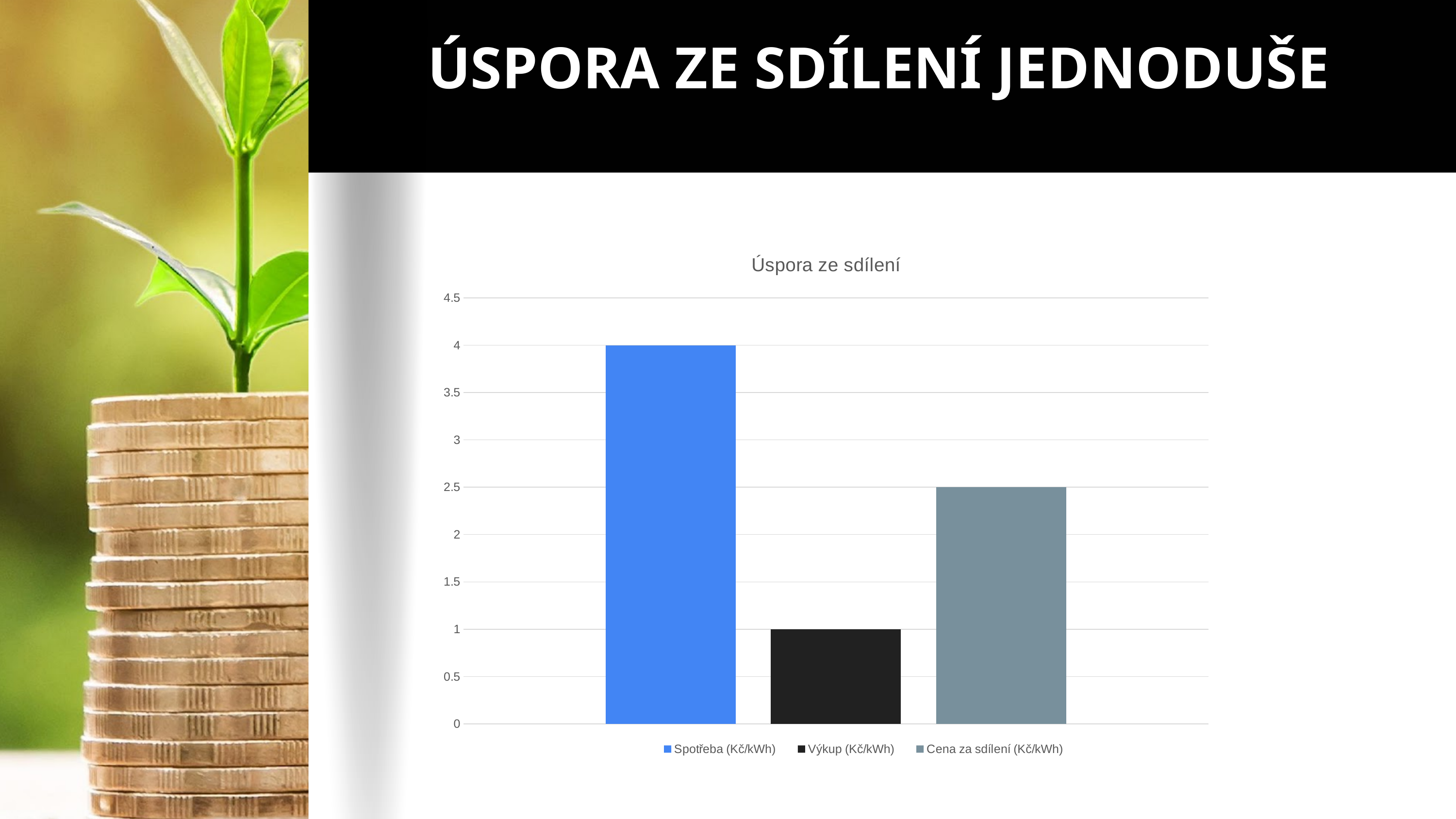
What is the value of Výkup (Kč/kWh)? 1 What is the value of Cena za sdílení (Kč/kWh)? 2.5 Which series has the highest value? Spotřeba (Kč/kWh) What colour is the bar for Výkup (Kč/kWh)? black What is the value of Spotřeba (Kč/kWh)? 4 How many series does the legend list? 3 Which series has the lowest value? Výkup (Kč/kWh) Which is larger, Cena za sdílení (Kč/kWh) or Výkup (Kč/kWh)? Cena za sdílení (Kč/kWh) What type of chart is shown on the slide? bar chart What is the title of the chart? Úspora ze sdílení What is the difference between Spotřeba (Kč/kWh) and Výkup (Kč/kWh)? 3 What is the difference between Spotřeba (Kč/kWh) and Cena za sdílení (Kč/kWh)? 1.5